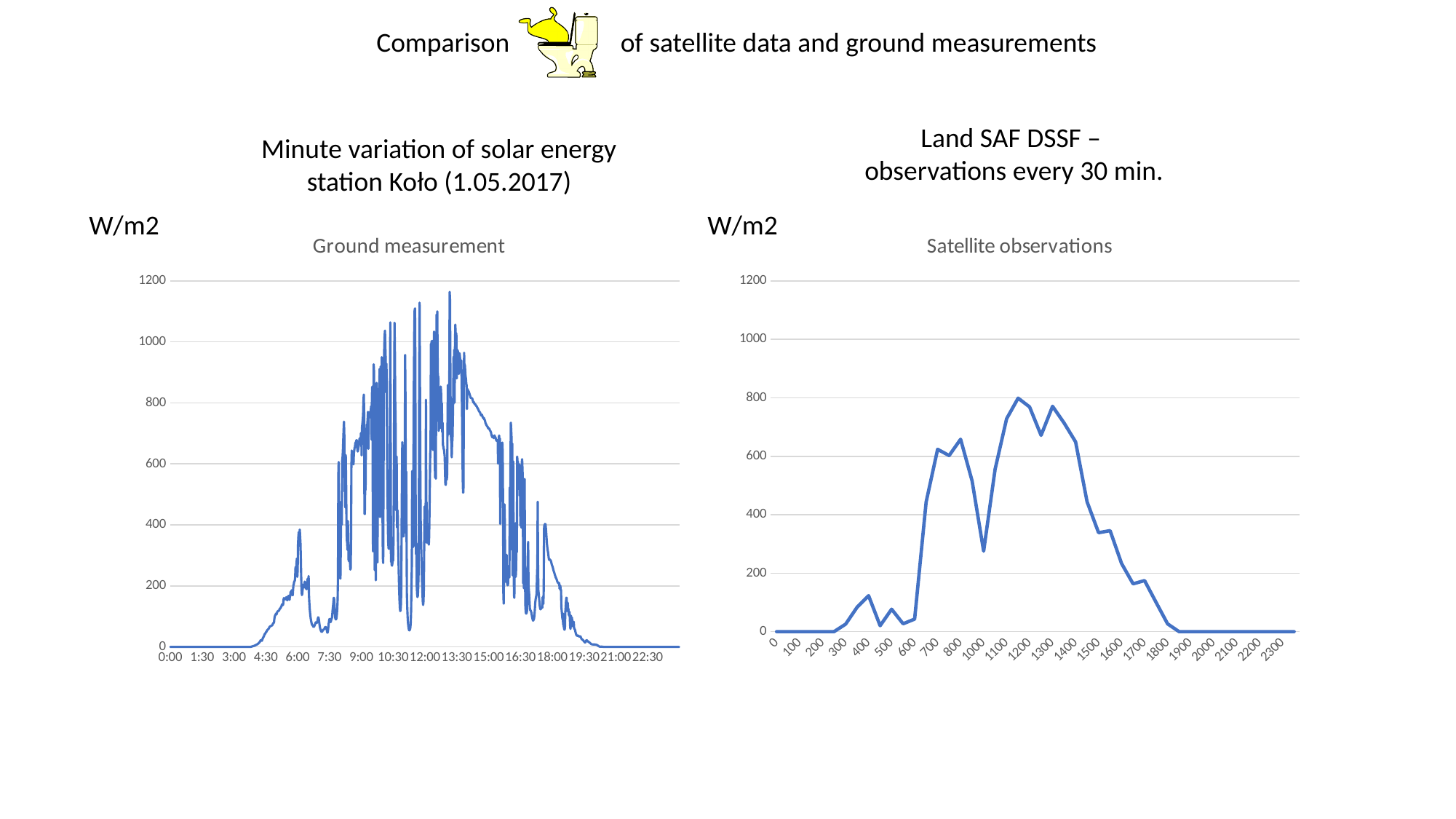
In the 'Ground measurement' chart, do the values generally rise or fall between 15:00 and 19:30? fall What kind of chart is the 'Ground measurement' chart on the left? line chart What unit is shown for the y axis of both charts? W/m2 In the 'Satellite observations' chart, is the value at 1000 greater or less than 400? less What kind of chart is the 'Satellite observations' chart on the right? line chart In the 'Ground measurement' chart, is the highest value greater or less than 1000? greater In the 'Ground measurement' chart, is the value at 6:00 greater or less than 600? less What is the title of the chart on the right? Satellite observations In the 'Satellite observations' chart, do the values rise or fall between 1300 and 1800 on the x axis? fall